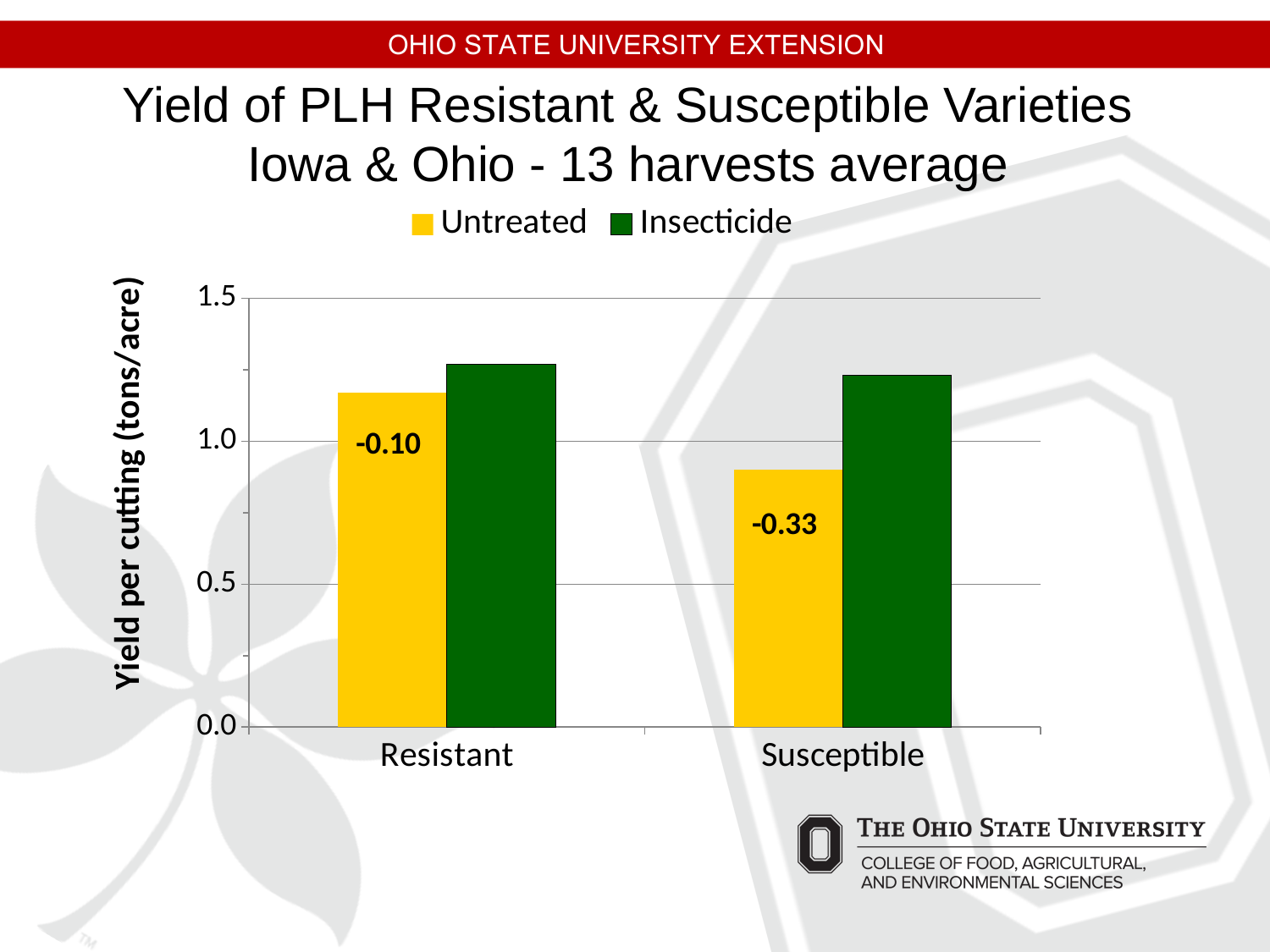
Which bar on the chart is the lowest? Susceptible, Untreated For the Susceptible variety, which is larger: the Untreated or the Insecticide yield? Insecticide What kind of chart is shown on the slide? bar chart How many categories are shown on the x axis? 2 Is the Insecticide value for Susceptible greater or less than 1.0? greater Which Untreated bar is larger: Resistant or Susceptible? Resistant What label is printed on the Untreated bar for Susceptible? -0.33 For the Resistant variety, which is larger: the Untreated or the Insecticide yield? Insecticide How many series does the legend list? 2 Is the Untreated value for Resistant greater or less than 1.0? greater Is the Untreated value for Susceptible greater or less than 1.0? less